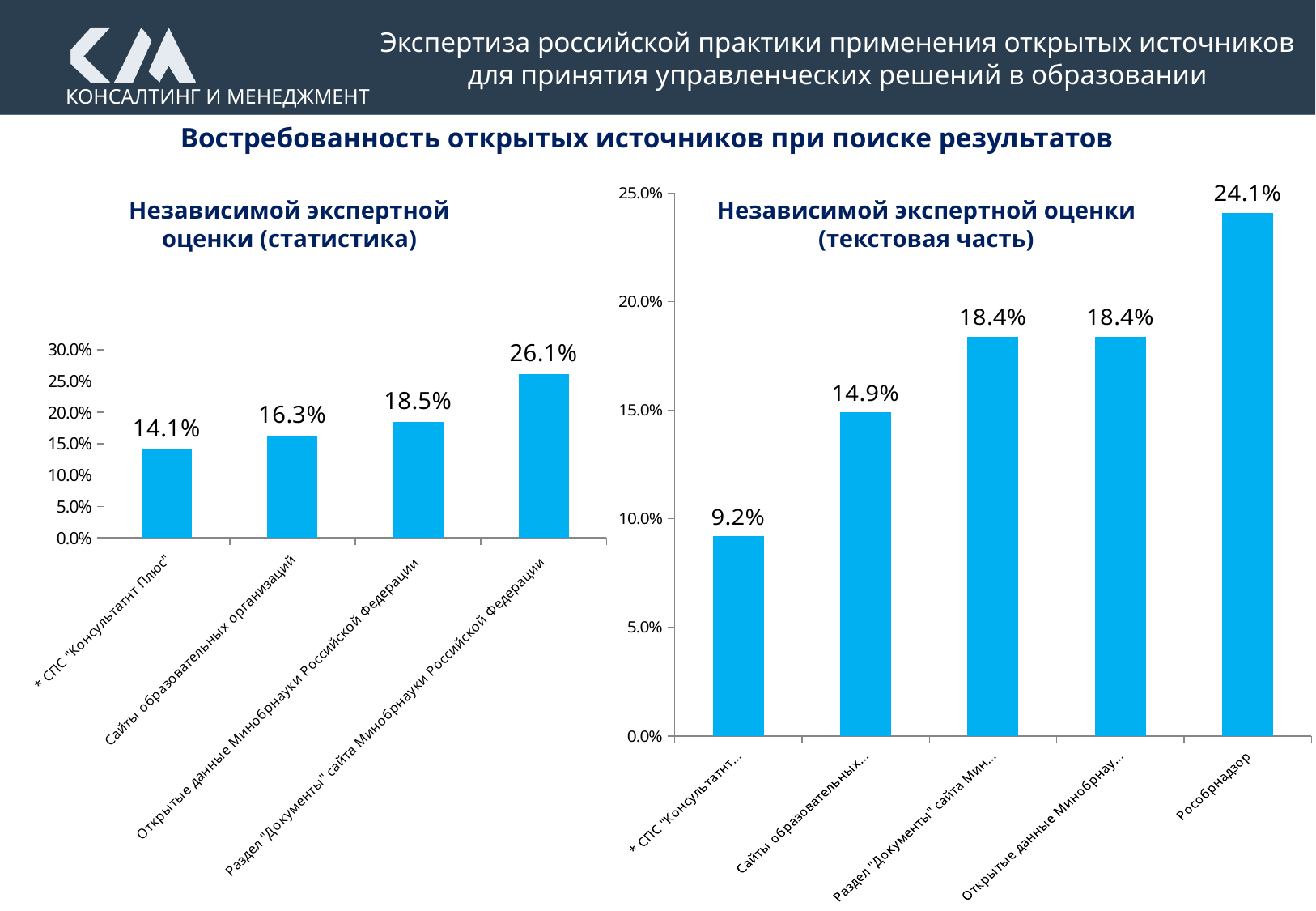
In the chart titled "Независимой экспертной оценки (текстовая часть)", what is the value for Рособрнадзор? 24.1% In the chart titled "Независимой экспертной оценки (текстовая часть)", what is the value for the first category, СПС "Консультант..."? 9.2% How many categories are shown in the chart titled "Независимой экспертной оценки (текстовая часть)"? 5 In the chart titled "Независимой экспертной оценки (текстовая часть)", what is the difference between the values for Рособрнадзор and Сайты образовательных...? 9.2% What type of chart is the chart titled "Независимой экспертной оценки (статистика)"? bar chart How many categories are shown in the chart titled "Независимой экспертной оценки (статистика)"? 4 In the chart titled "Независимой экспертной оценки (статистика)", what is the difference between the values for Раздел "Документы" сайта Минобрнауки and Открытые данные Минобрнауки? 7.6% In the chart titled "Независимой экспертной оценки (статистика)", which category has the highest value? Раздел "Документы" сайта Минобрнауки Российской Федерации In the chart titled "Независимой экспертной оценки (текстовая часть)", which category has the lowest value? СПС "Консультант..." In the chart titled "Независимой экспертной оценки (текстовая часть)", is the value for Сайты образовательных... greater or less than 15.0%? less In the chart titled "Независимой экспертной оценки (статистика)", which category has the lowest value? СПС "Консультант Плюс" In the chart titled "Независимой экспертной оценки (статистика)", what is the value for Сайты образовательных организаций? 16.3%